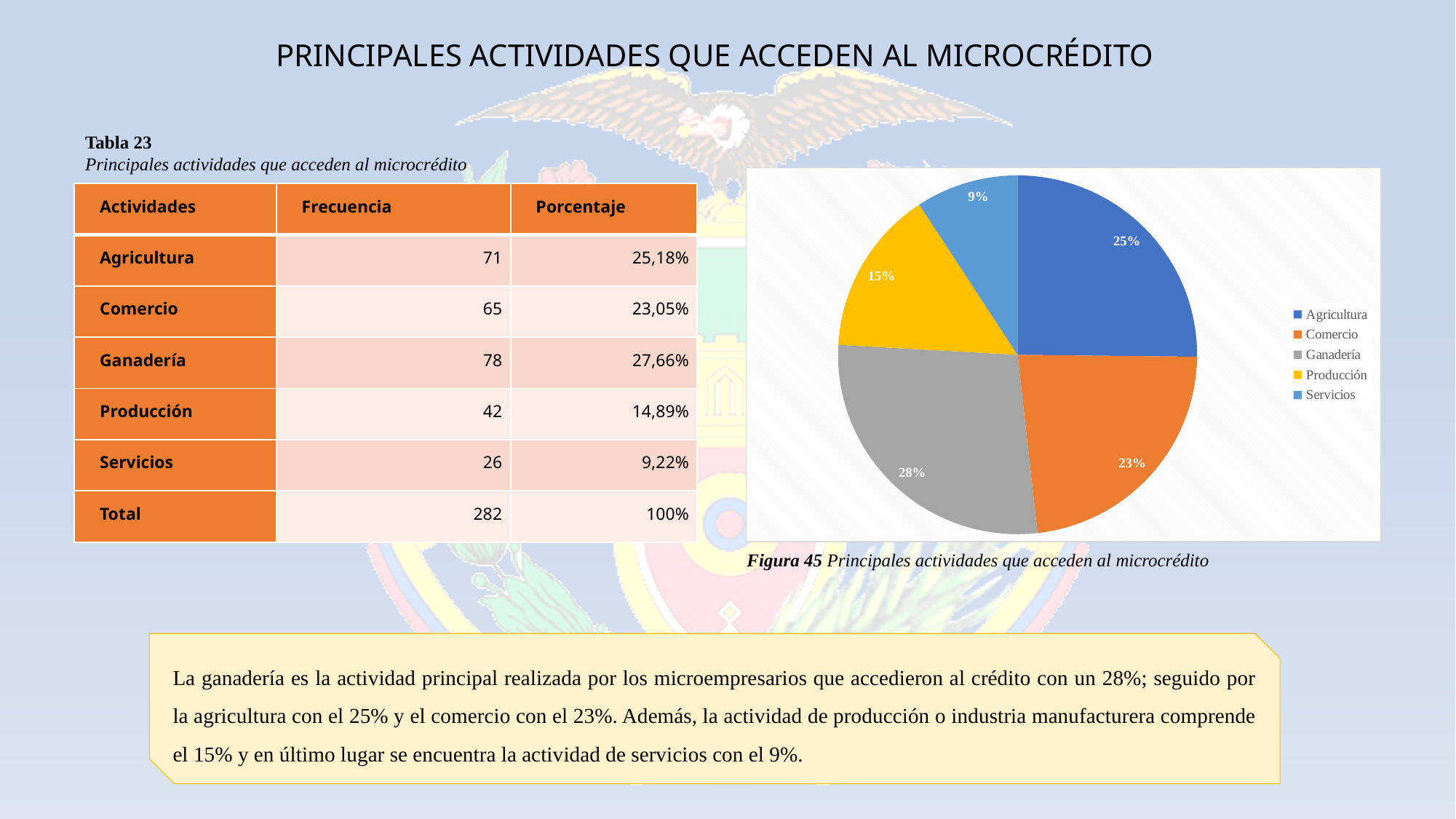
How many slices does the pie chart have? 5 What colour is the Producción slice in the pie chart? yellow In the pie chart, what percentage is shown for Producción? 15% In the pie chart, which slice is larger: Comercio or Producción? Comercio What kind of chart is shown in Figura 45? pie chart In the pie chart, what percentage is shown for Ganadería? 28% Which activity has the largest slice in the pie chart? Ganadería How many entries does the legend of the pie chart list? 5 In the pie chart, what percentage is shown for Agricultura? 25% Which activity has the smallest slice in the pie chart? Servicios In the pie chart, what is the difference in percentage points between Ganadería and Servicios? 19 In the pie chart, what percentage is shown for Servicios? 9%